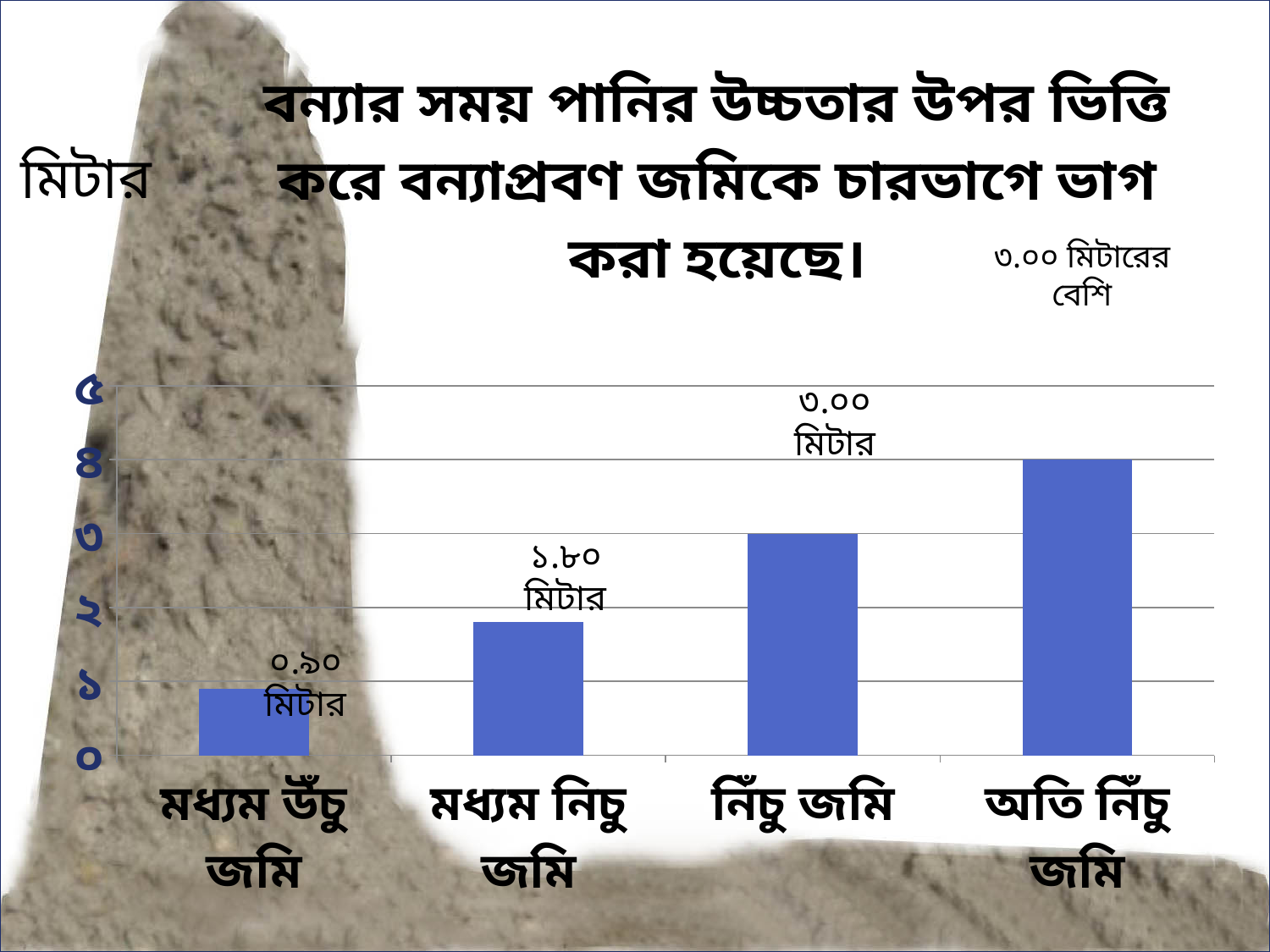
What value is labelled on the bar for মধ্যম উঁচু জমি? ০.৯০ মিটার What is the difference between the values for মধ্যম নিচু জমি and মধ্যম উঁচু জমি? ০.৯০ মিটার Is the value for অতি নিচু জমি greater or less than ৩? greater How many categories are shown on the x axis? 4 What value is labelled on the bar for মধ্যম নিচু জমি? ১.৮০ মিটার What kind of chart is shown on the slide? bar chart Which is larger, the value for নিচু জমি or the value for মধ্যম নিচু জমি? নিচু জমি Do the bar values rise or fall from left to right along the x axis? rise Which category has the tallest bar? অতি নিচু জমি What value is labelled on the bar for নিচু জমি? ৩.০০ মিটার Which category has the shortest bar? মধ্যম উঁচু জমি What label is given for the bar for অতি নিচু জমি? ৩.০০ মিটারের বেশি